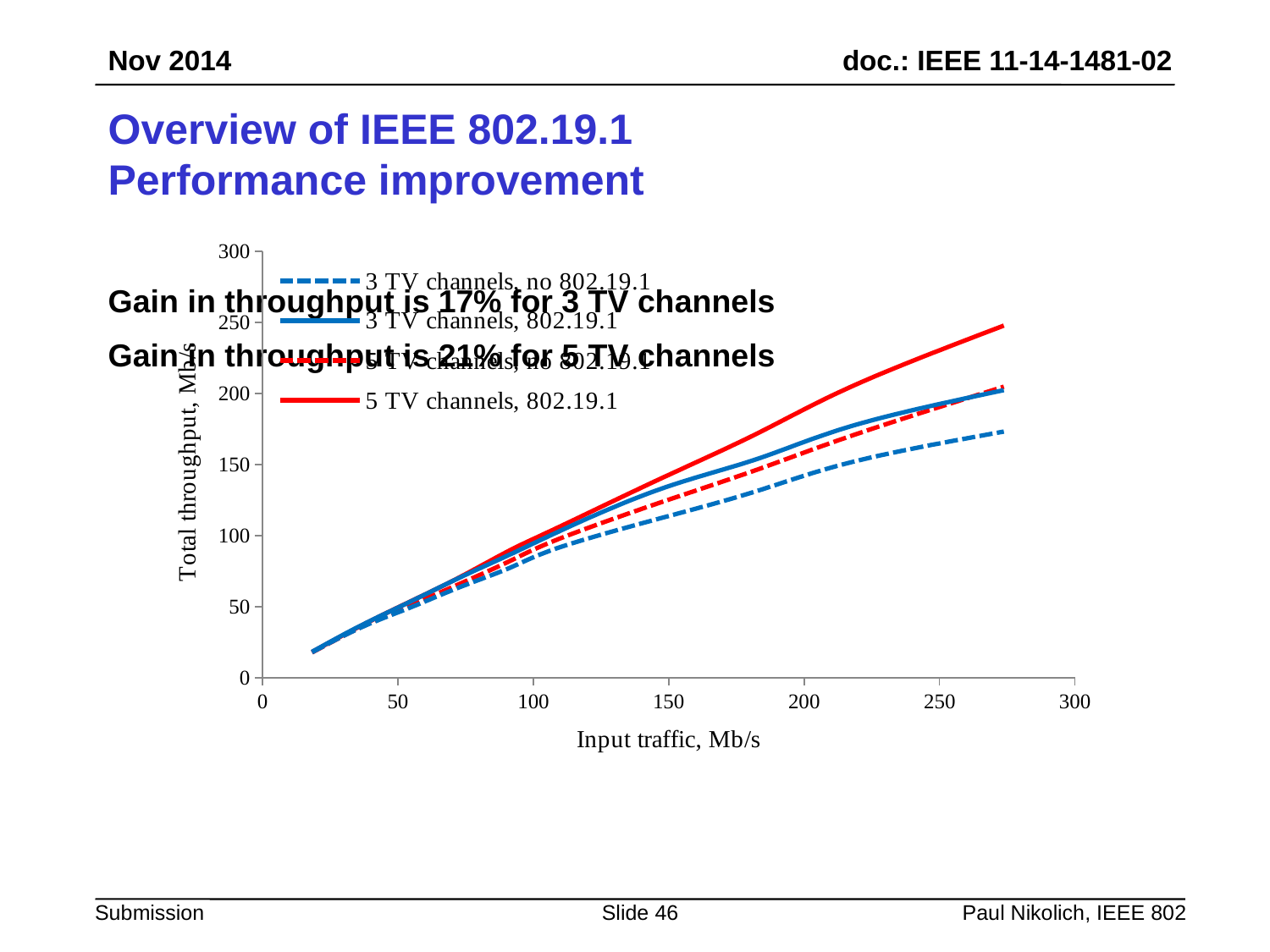
At the highest input traffic plotted, is the total throughput for '3 TV channels, no 802.19.1' greater or less than 200? less At an input traffic of 200 Mb/s, is the total throughput for '3 TV channels, no 802.19.1' greater or less than 150? less Does total throughput rise or fall as input traffic increases along the x axis? Rises What is the title of the x axis? Input traffic, Mb/s At the highest input traffic plotted, which series has the larger total throughput: '5 TV channels, 802.19.1' or '3 TV channels, no 802.19.1'? 5 TV channels, 802.19.1 What is the title of the y axis? Total throughput, Mb/s Which series reaches the highest total throughput at the right end of the chart? 5 TV channels, 802.19.1 Which series has the lowest total throughput at the right end of the chart? 3 TV channels, no 802.19.1 At the highest input traffic plotted, is the total throughput for '5 TV channels, 802.19.1' greater or less than 200? greater What kind of chart is shown on the slide? Line chart How many series does the legend list? 4